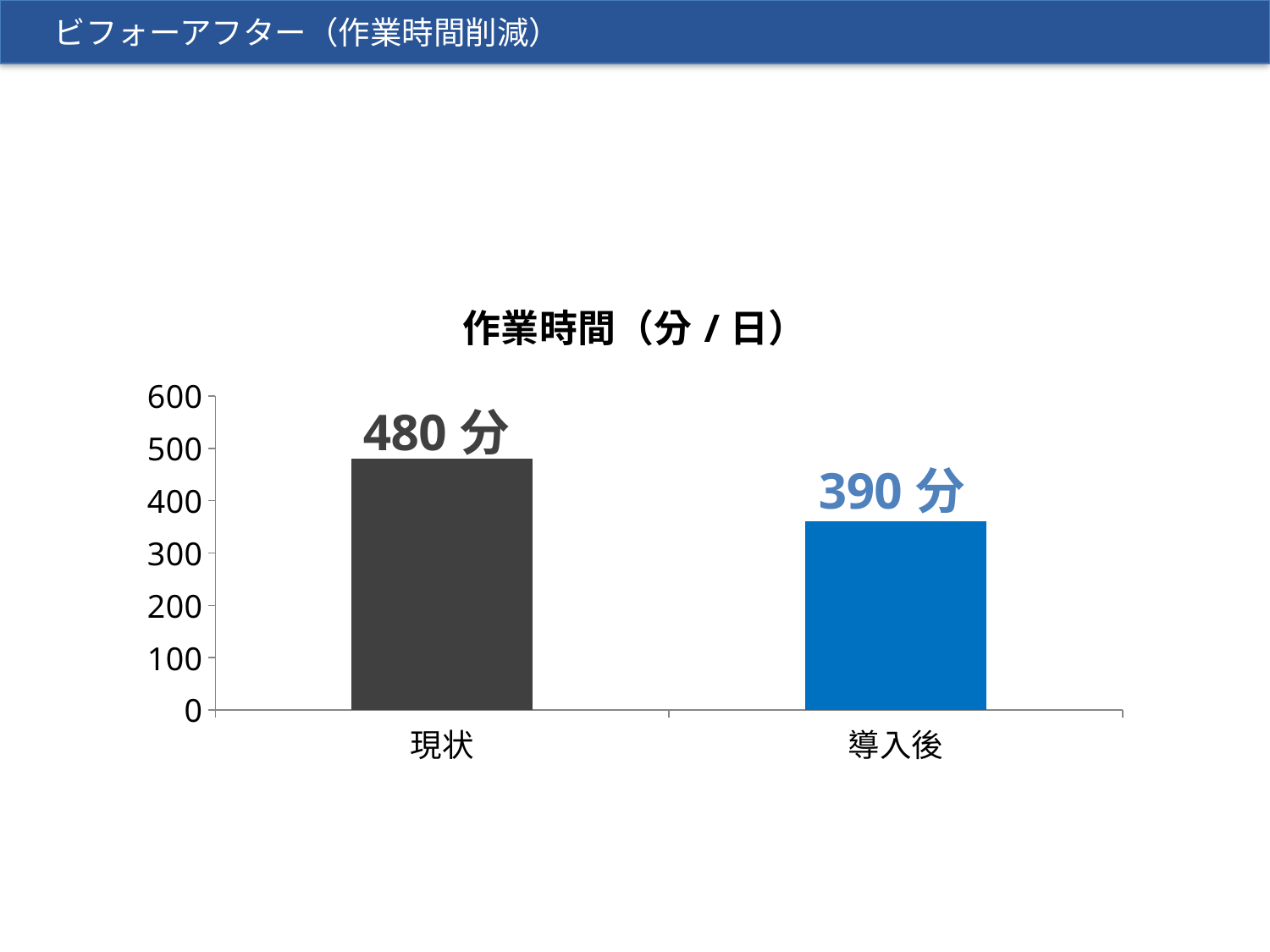
Which category has the highest value? 現状 What is the difference between the values for 現状 and 導入後? 90 分 Is the value for 導入後 greater or less than 500? less Is the value for 現状 greater or less than 400? greater How many categories are shown on the x axis? 2 Which category has the lowest value? 導入後 Which is larger, the value for 現状 or the value for 導入後? 現状 What is the value for 現状? 480 分 What is the title of the chart? 作業時間（分 / 日） Do the values rise or fall from 現状 to 導入後? fall What is the value for 導入後? 390 分 What kind of chart is shown on the slide? bar chart